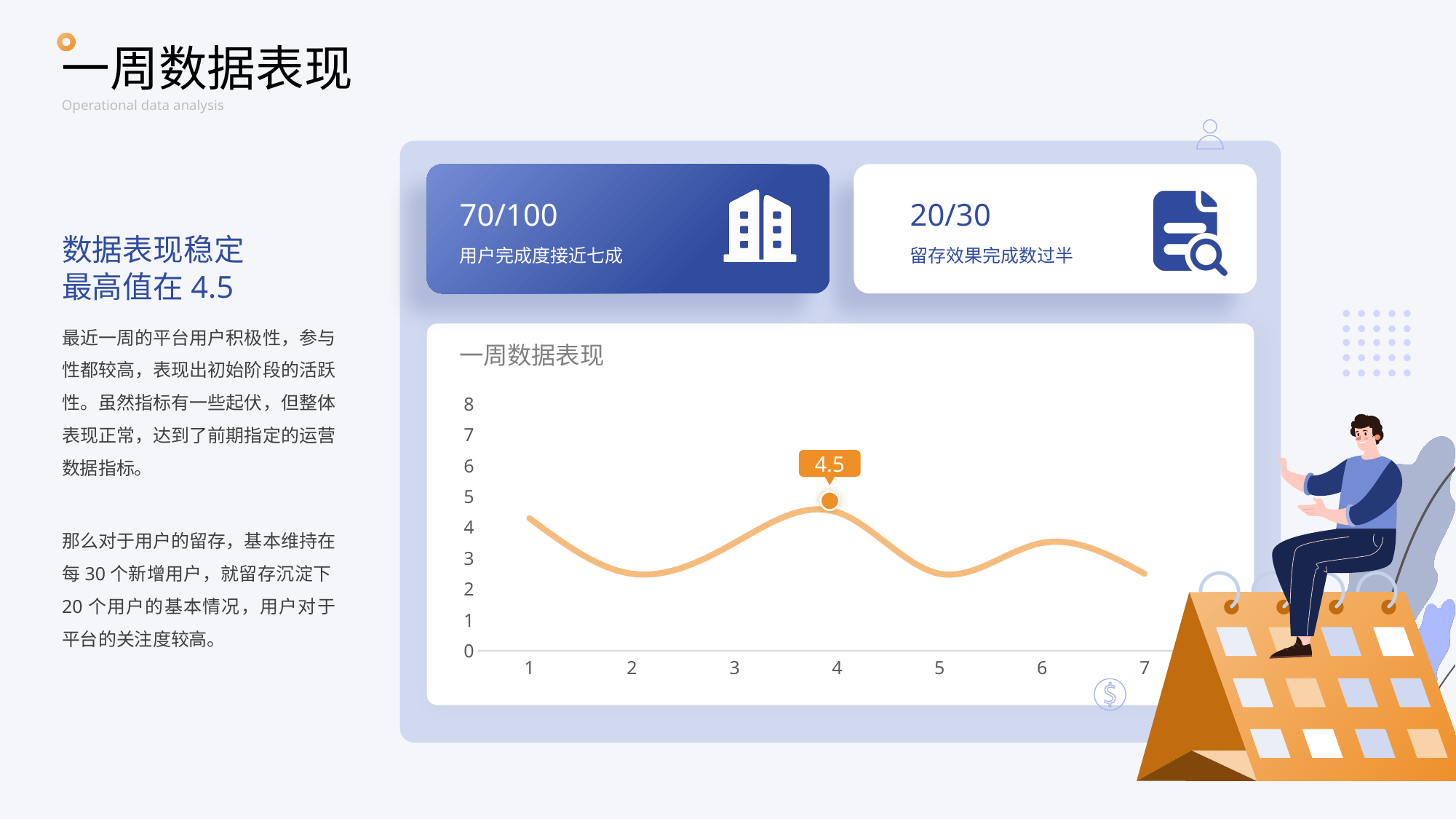
What is the title of the chart? 一周数据表现 What kind of chart is shown on the slide? line chart What is the highest value shown on the y axis of the chart? 8 Is the value at point 7 greater or less than 3? less Is the value at point 2 greater or less than 3? less Which has the larger value, point 1 or point 2? point 1 Is the value at point 4 greater or less than 4? greater Which x-axis point has the highest value on the line chart? 4 Does the line rise or fall from point 4 to point 5? fall What is the value at point 4 on the line chart? 4.5 How many data points are plotted on the line chart? 7